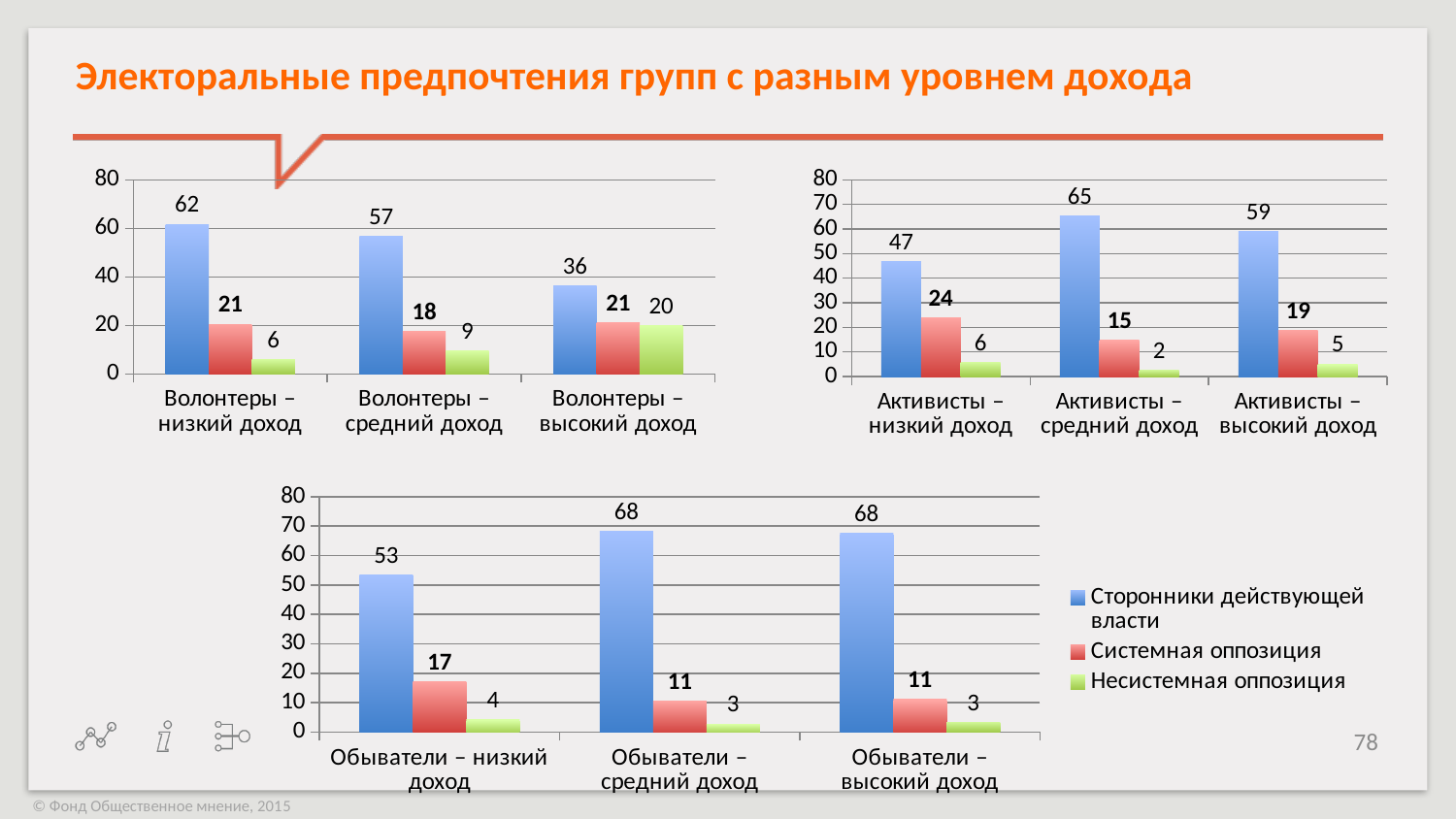
What type of chart is the top-left chart (Волонтеры)? bar chart In the top-right chart (Активисты), what is the value for Системная оппозиция among Активисты – низкий доход? 24 In the top-right chart (Активисты), which income group has the highest value for Сторонники действующей власти? Активисты – средний доход In the top-left chart (Волонтеры), what is the value for Сторонники действующей власти among Волонтеры – низкий доход? 62 In the bottom chart (Обыватели), which is larger: Системная оппозиция for низкий доход or for средний доход? низкий доход In the top-left chart (Волонтеры), which income group has the lowest value for Сторонники действующей власти? Волонтеры – высокий доход In the top-right chart (Активисты), is the value for Сторонники действующей власти among Активисты – низкий доход greater or less than 40? greater In the top-left chart (Волонтеры), do the values for Сторонники действующей власти rise or fall from низкий доход to высокий доход? fall How many income groups are shown on the x axis of the bottom chart (Обыватели)? 3 In the top-left chart (Волонтеры), what is the difference between the Сторонники действующей власти values for низкий доход and высокий доход? 26 How many series does the legend on the slide list? 3 In the bottom chart (Обыватели), what is the value for Несистемная оппозиция among Обыватели – низкий доход? 4